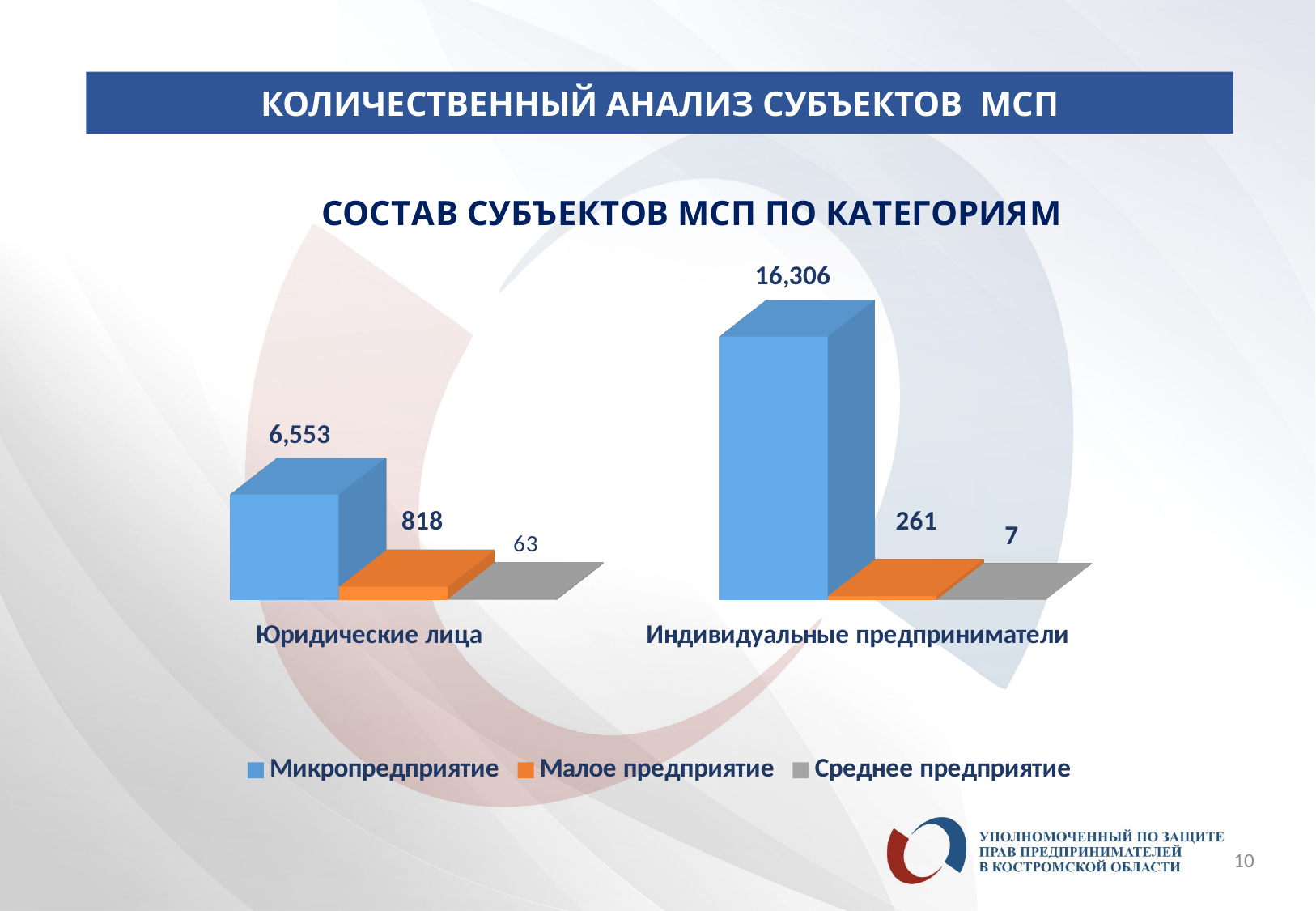
Which series has the highest value in the Индивидуальные предприниматели category? Микропредприятие What is the value for Малое предприятие in the Индивидуальные предприниматели category? 261 How many series does the legend list? 3 How many categories are shown on the x axis? 2 What kind of chart is shown on the slide? Bar chart What is the difference between the Микропредприятие values for Индивидуальные предприниматели and Юридические лица? 9,753 Which series has the lowest value in the Юридические лица category? Среднее предприятие Which is larger: Малое предприятие for Юридические лица or Малое предприятие for Индивидуальные предприниматели? Юридические лица What is the title of the chart? СОСТАВ СУБЪЕКТОВ МСП ПО КАТЕГОРИЯМ What is the value for Среднее предприятие in the Юридические лица category? 63 What is the value for Микропредприятие in the Индивидуальные предприниматели category? 16,306 What is the value for Микропредприятие in the Юридические лица category? 6,553